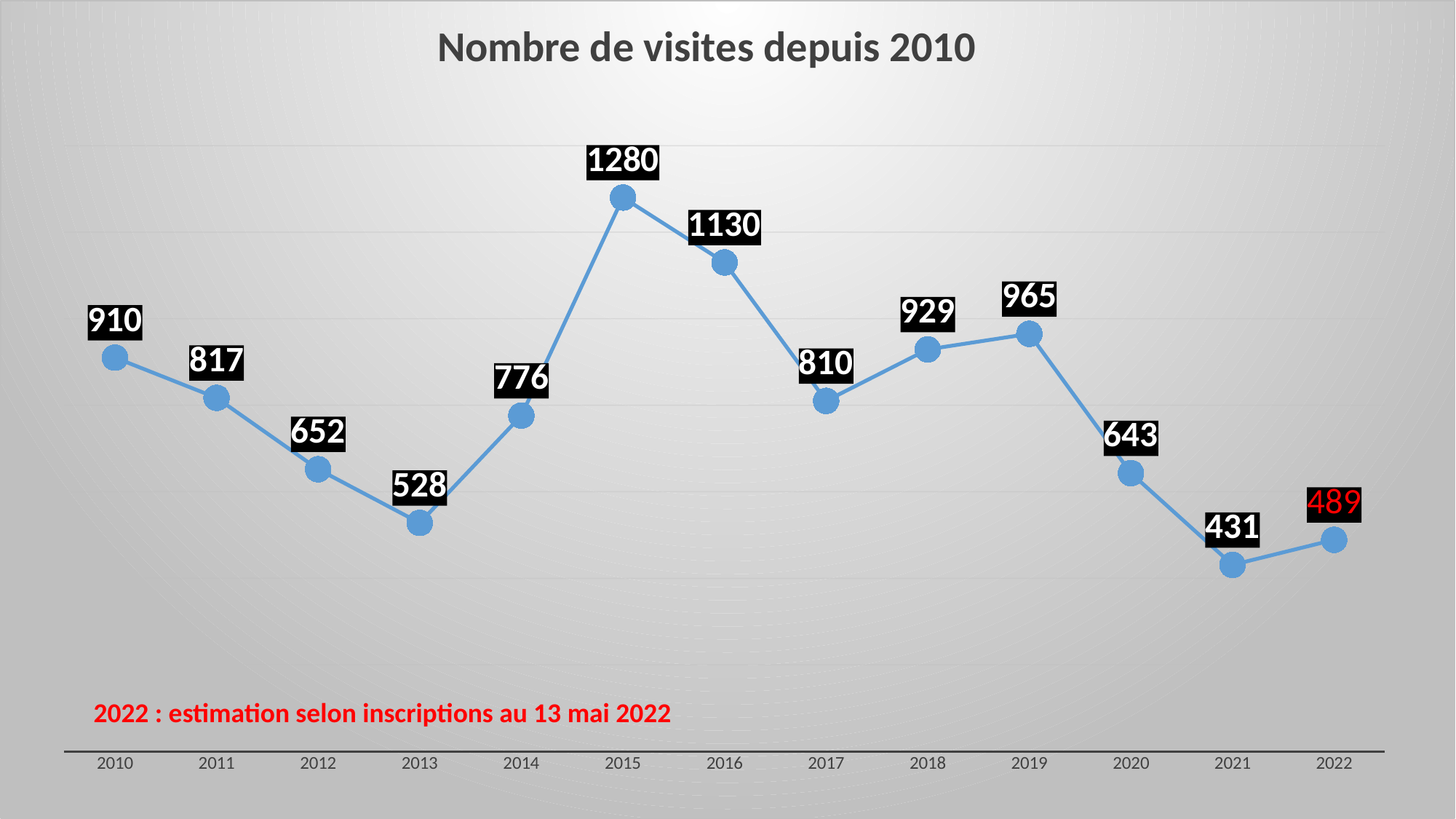
What is the title of the chart? Nombre de visites depuis 2010 What is the number of visits in 2015? 1280 What is the number of visits in 2013? 528 What is the difference in visits between 2010 and 2011? 93 Which year had more visits, 2018 or 2019? 2019 What is the estimated number of visits for 2022? 489 Which year has the lowest number of visits? 2021 Which year has the highest number of visits? 2015 How many years are plotted on the chart? 13 What kind of chart is shown on the slide? line chart Do the visits rise or fall from 2019 to 2021? fall What is the difference in visits between 2015 and 2016? 150